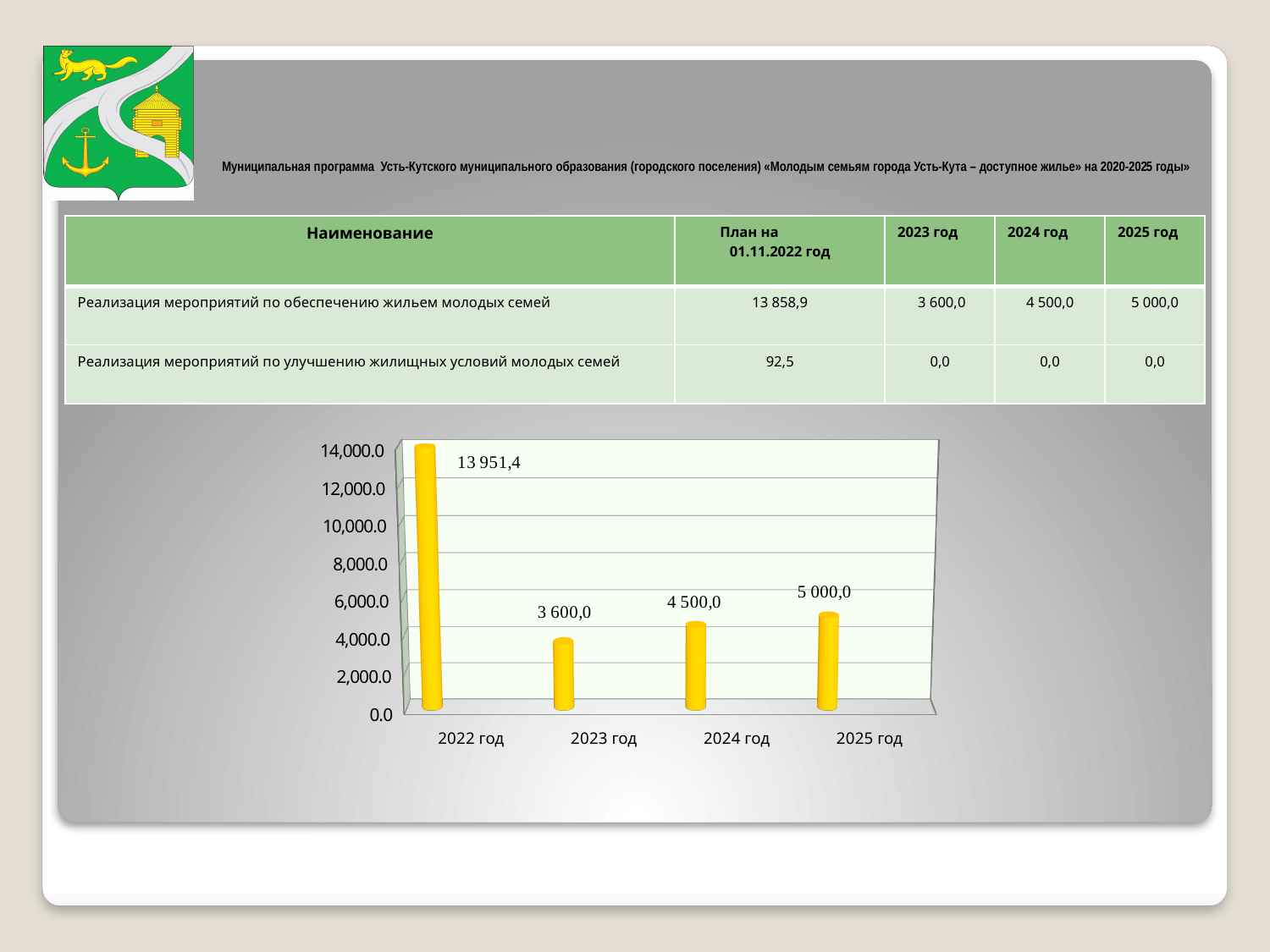
Which year has the lowest value on the chart? 2023 год How many years are shown on the x axis of the chart? 4 What is the value shown for 2024 год on the chart? 4 500,0 What is the value shown for 2025 год on the chart? 5 000,0 Is the value for 2022 год greater or less than 12,000.0? greater What is the value shown for 2022 год on the chart? 13 951,4 Which year has the highest value on the chart? 2022 год Do the values rise or fall from 2023 год to 2025 год? rise What kind of chart is shown on the slide? bar chart What is the difference between the values for 2025 год and 2024 год? 500,0 What is the value shown for 2023 год on the chart? 3 600,0 Which is larger, the value for 2024 год or the value for 2023 год? 2024 год